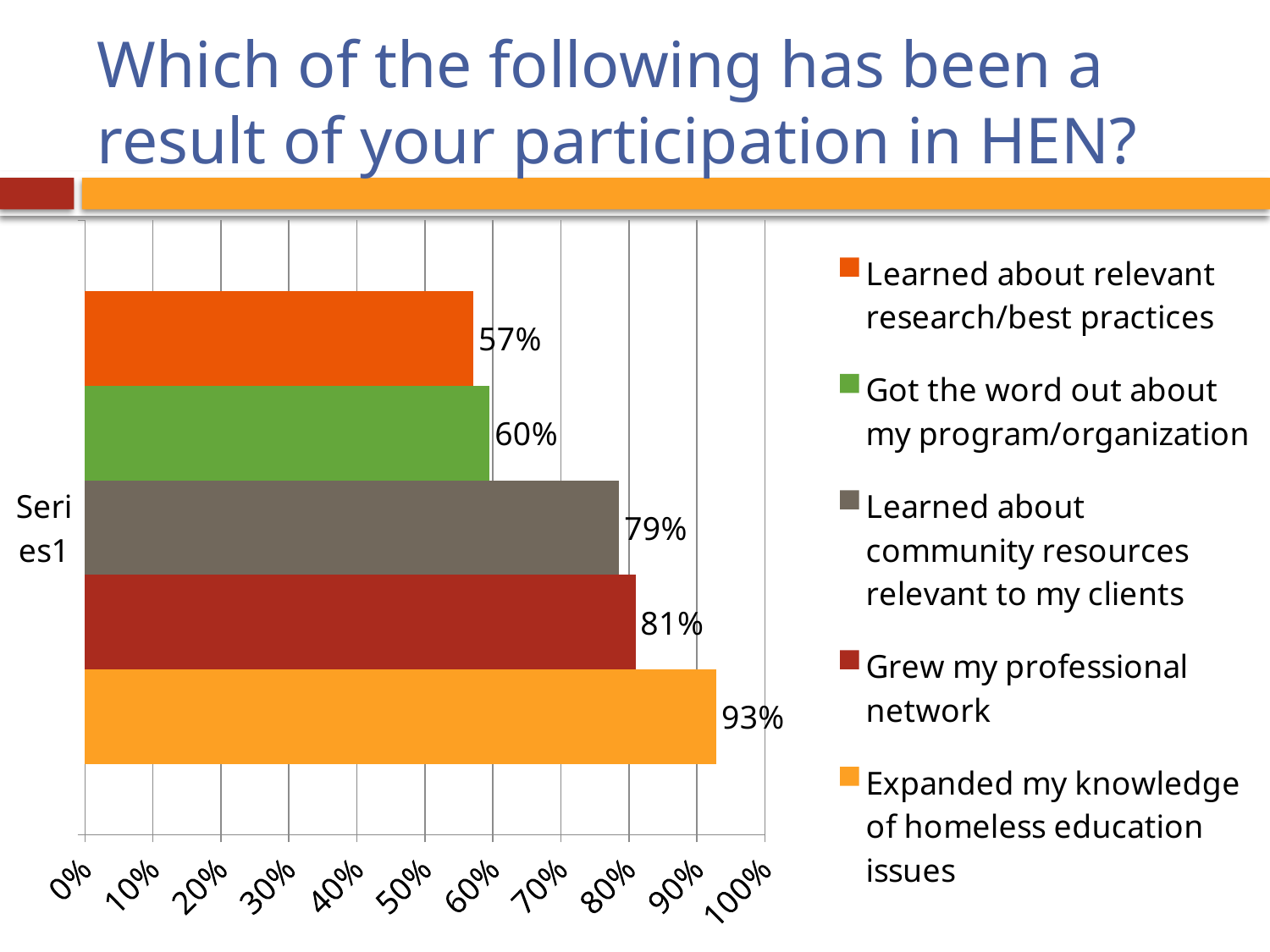
Which result of participation in HEN has the highest percentage? Expanded my knowledge of homeless education issues What is the value for 'Got the word out about my program/organization'? 60% What colour is the bar for 'Grew my professional network'? Dark red Which result of participation in HEN has the lowest percentage? Learned about relevant research/best practices What percentage of respondents said they learned about community resources relevant to their clients? 79% How many legend entries does the chart list? 5 What is the difference between 'Expanded my knowledge of homeless education issues' and 'Grew my professional network'? 12% What percentage of respondents said they learned about relevant research/best practices? 57% What is the value for 'Grew my professional network'? 81% What is the value for 'Expanded my knowledge of homeless education issues'? 93% What kind of chart is shown on the slide? Bar chart Which is larger: 'Learned about community resources relevant to my clients' or 'Got the word out about my program/organization'? Learned about community resources relevant to my clients